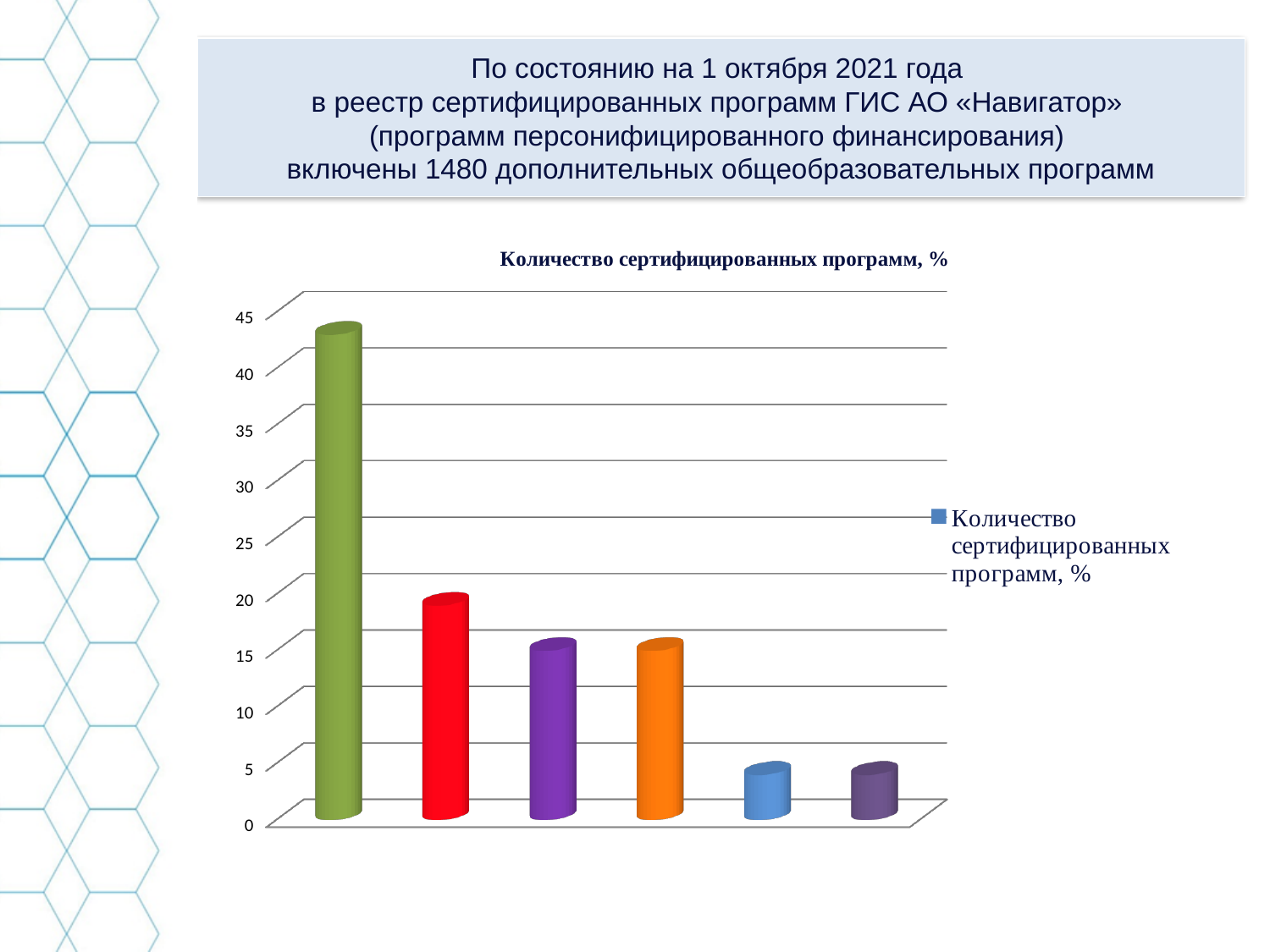
Which bar is the highest in the chart? The green bar (first from the left) Is the value of the orange bar greater or less than 10? greater Is the value of the light blue bar greater or less than 10? less Is the value of the purple (third) bar greater or less than 20? less Which is larger, the green bar or the red bar? The green bar How many series does the legend list? 1 What is the title of the chart? Количество сертифицированных программ, % Which is larger, the red bar or the purple (third) bar? The red bar What kind of chart is shown on the slide? Bar chart How many bars are plotted in the chart? 6